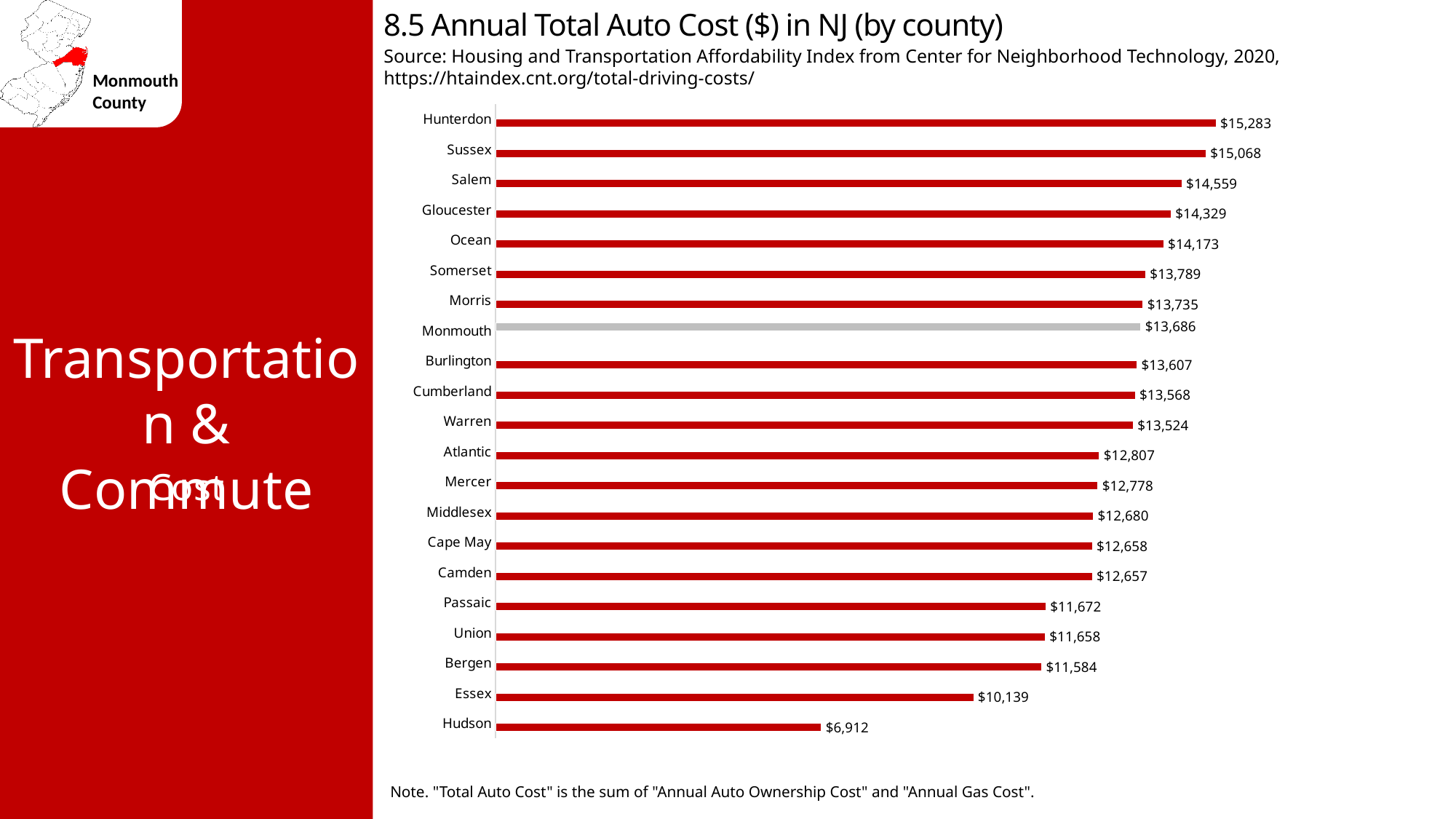
What is the annual total auto cost for Monmouth County? $13,686 What type of chart is used to show annual total auto cost by county? Bar chart Which county has the lowest annual total auto cost? Hudson What is the annual total auto cost for Hudson County? $6,912 Which county has the highest annual total auto cost? Hunterdon Which county has a higher annual total auto cost, Sussex or Salem? Sussex What is the annual total auto cost for Ocean County? $14,173 What is the difference in annual total auto cost between Monmouth and Essex? $3,547 Which county's bar is shown in gray instead of red? Monmouth How many counties are shown in the chart? 21 What is the difference in annual total auto cost between Hunterdon and Hudson? $8,371 Which county has a higher annual total auto cost, Bergen or Essex? Bergen